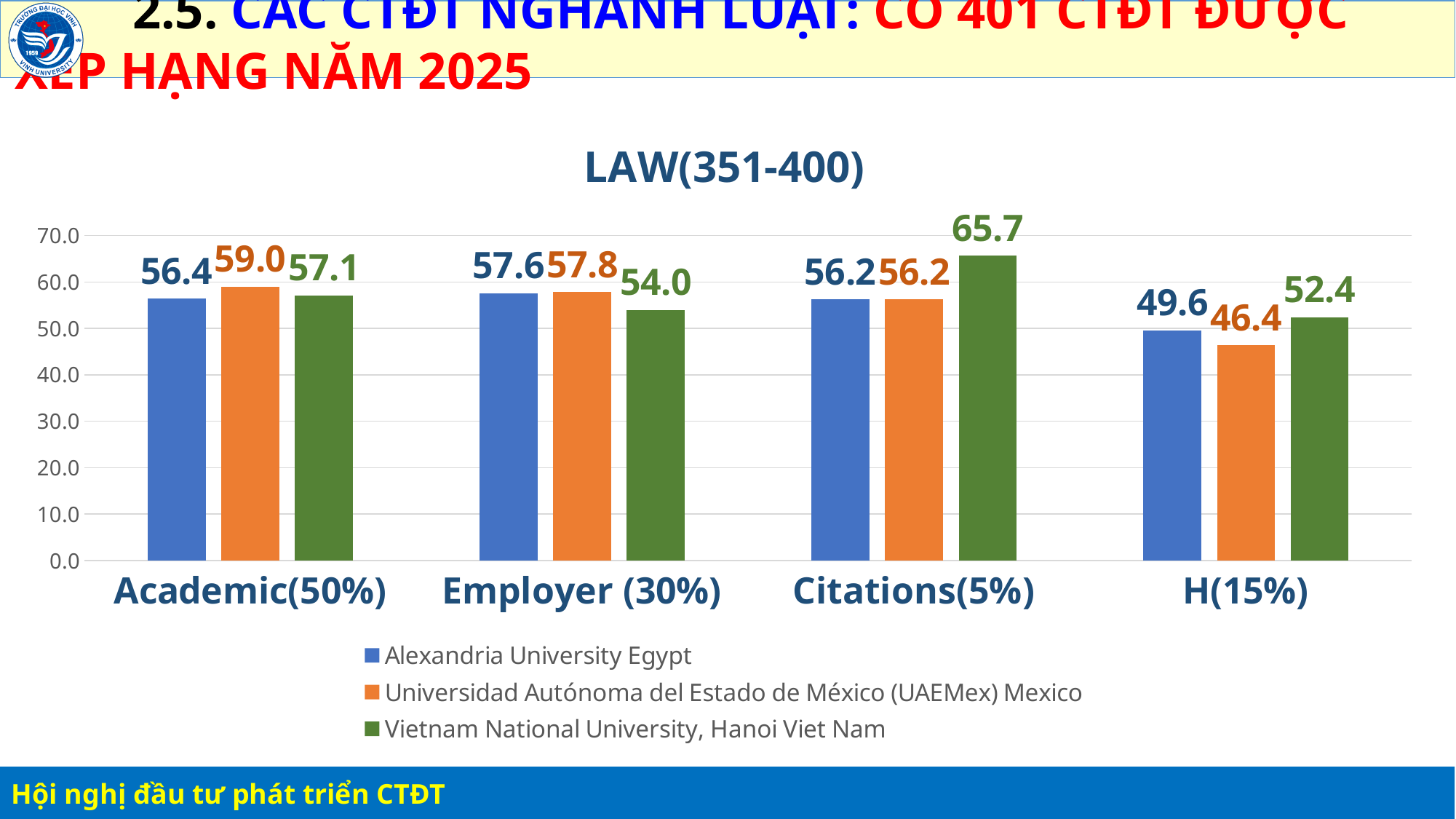
Is the value for Universidad Autónoma del Estado de México (UAEMex) Mexico in the H(15%) category greater or less than 50.0? less What is the value for Vietnam National University, Hanoi Viet Nam in the Citations(5%) category? 65.7 Which series has the highest value in the Citations(5%) category? Vietnam National University, Hanoi Viet Nam What is the value for Universidad Autónoma del Estado de México (UAEMex) Mexico in the Academic(50%) category? 59.0 In the Academic(50%) category, which is larger: the value for Alexandria University Egypt or the value for Vietnam National University, Hanoi Viet Nam? Vietnam National University, Hanoi Viet Nam What is the difference between the Vietnam National University, Hanoi Viet Nam value and the Alexandria University Egypt value in the Citations(5%) category? 9.5 What is the title of the chart? LAW(351-400) What is the value for Alexandria University Egypt in the H(15%) category? 49.6 How many categories are shown on the x axis? 4 What is the difference between the Universidad Autónoma del Estado de México (UAEMex) Mexico value and the Vietnam National University, Hanoi Viet Nam value in the Employer (30%) category? 3.8 Which series has the lowest value in the H(15%) category? Universidad Autónoma del Estado de México (UAEMex) Mexico How many series does the legend list? 3